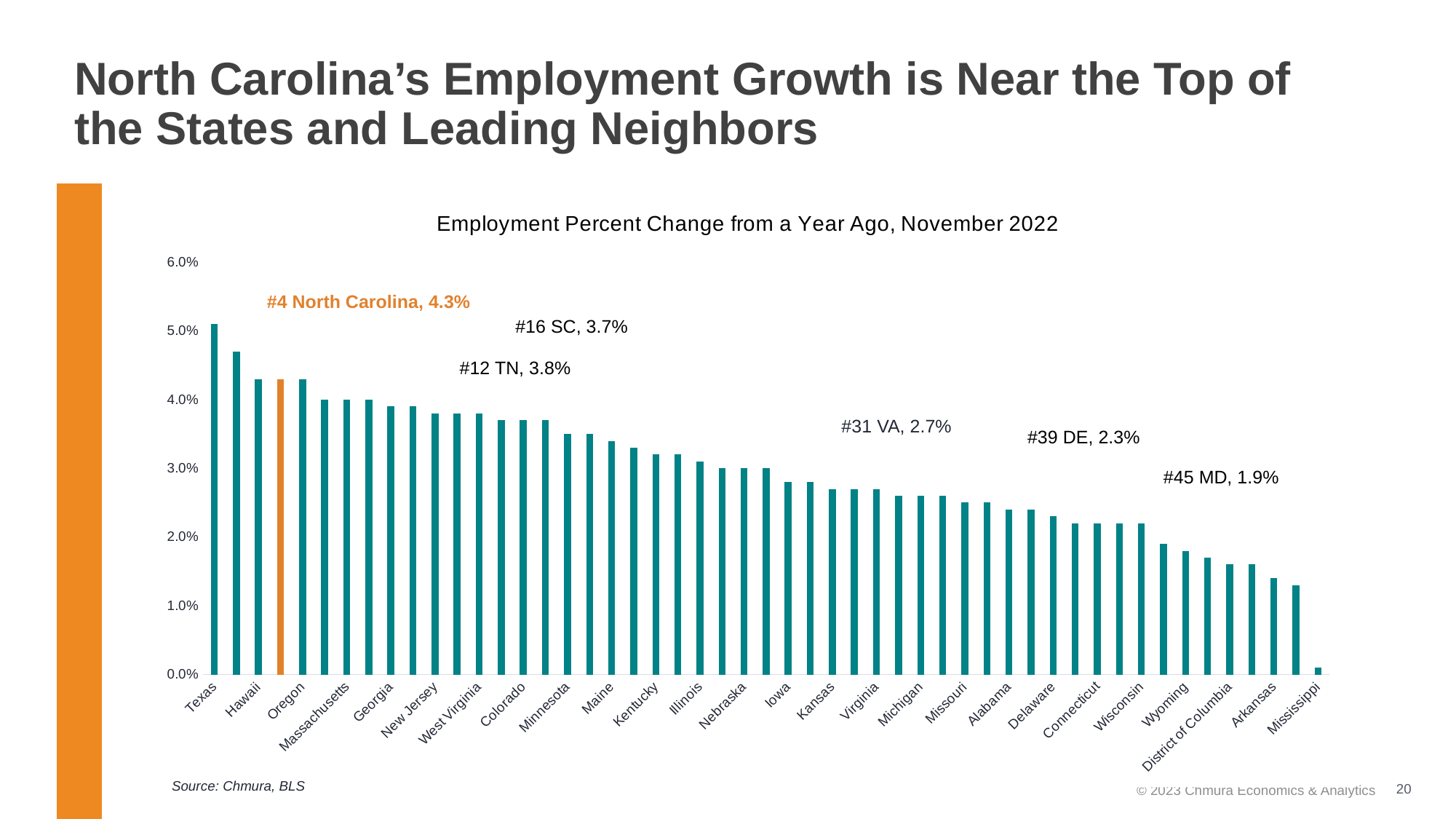
What is the employment percent change for MD (Maryland)? 1.9% Which state has the highest employment percent change? Texas What is the employment percent change for SC (South Carolina)? 3.7% How many percentage points higher is North Carolina's value than South Carolina's? 0.6 percentage points What is the employment percent change for TN (Tennessee)? 3.8% What kind of chart is shown on the slide? Bar chart What is the employment percent change for North Carolina? 4.3% Which state has the lowest employment percent change? Mississippi What rank does Virginia hold in the chart? #31 Is the value for Arkansas greater or less than 2.0%? less Which has a larger employment percent change, Delaware or Maryland? Delaware Is the value for Hawaii greater or less than 4.0%? greater